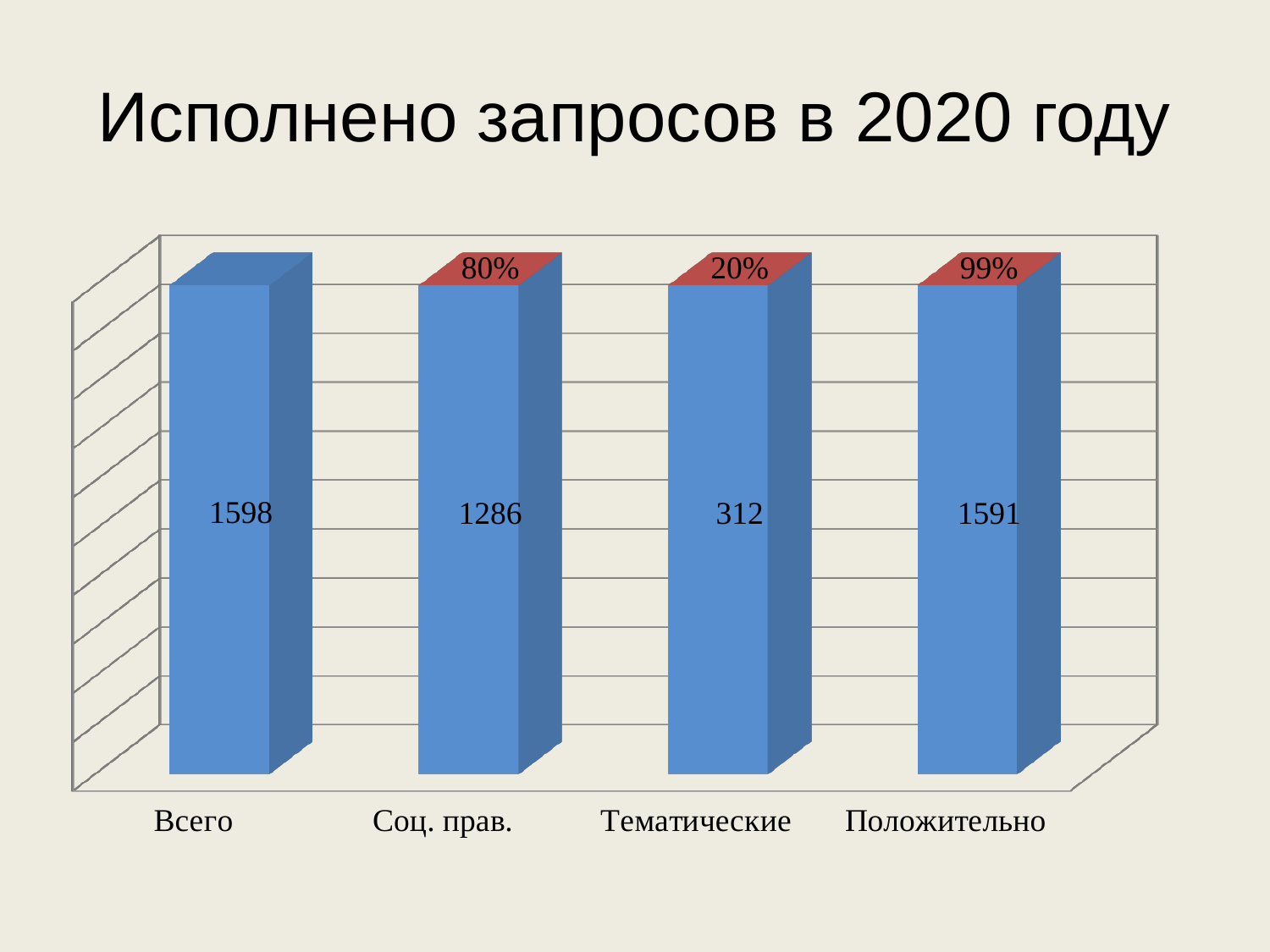
What value is shown for the "Тематические" bar? 312 What is the title of the slide? Исполнено запросов в 2020 году Which category has the lowest labelled value? Тематические What percentage label is shown above the "Тематические" bar? 20% What is the difference between the values for "Всего" and "Положительно"? 7 What percentage label is shown above the "Соц. прав." bar? 80% Which category has the highest labelled value? Всего What percentage label is shown above the "Положительно" bar? 99% How many categories are shown on the x axis? 4 What value is shown for the "Всего" bar? 1598 What value is shown for the "Соц. прав." bar? 1286 What value is shown for the "Положительно" bar? 1591